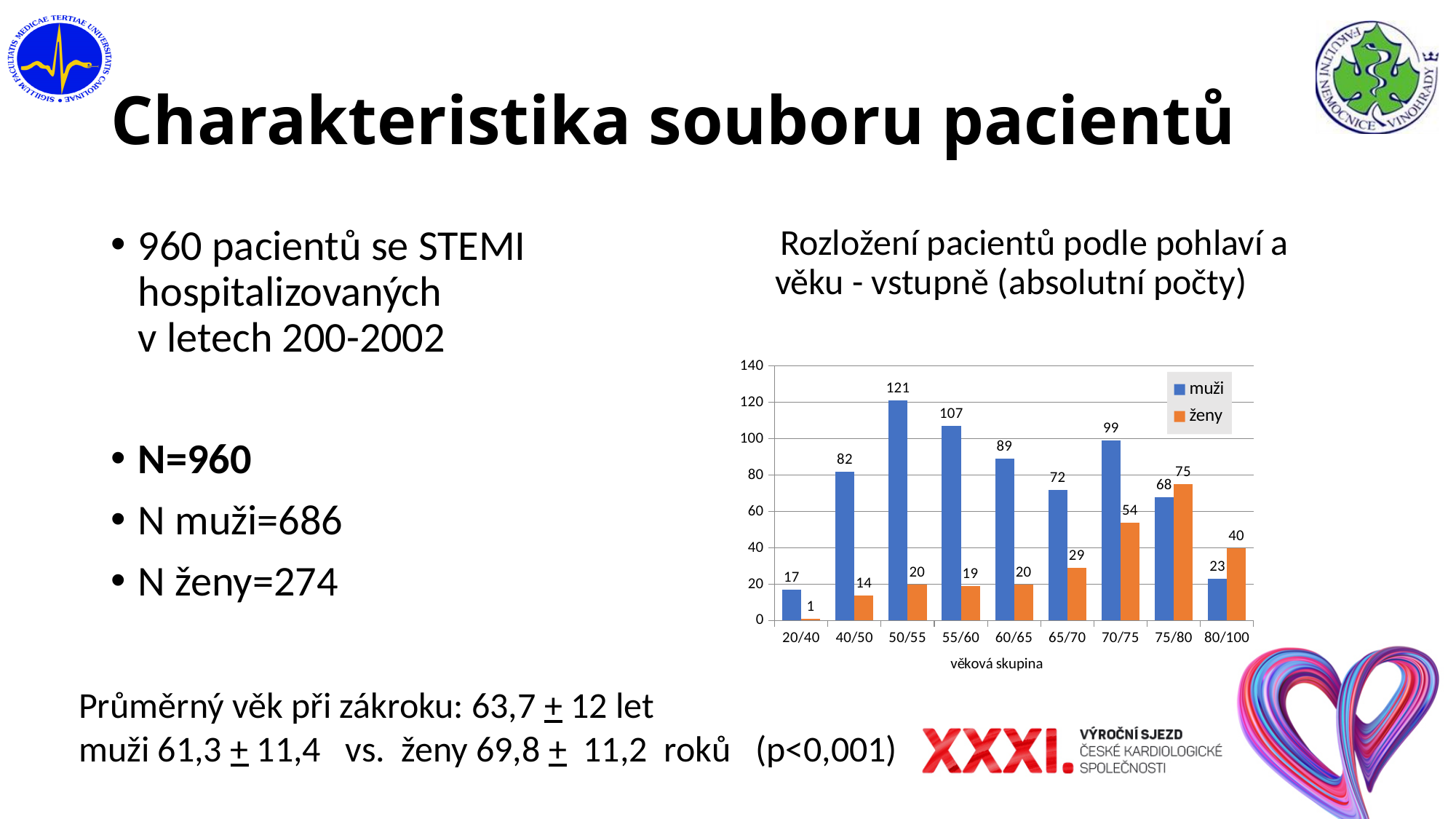
What is the difference between muži and ženy in the 60/65 age group? 69 What is the value for muži in the 50/55 age group? 121 What is the value for ženy in the 70/75 age group? 54 How many age groups are shown on the x axis? 9 Which age group has the lowest value for ženy? 20/40 What kind of chart is shown on the slide? bar chart Do the values for ženy rise or fall from the 65/70 age group to the 80/100 age group? rise How many series does the legend list? 2 In the 75/80 age group, which series has the larger value, muži or ženy? ženy Which age group has the highest value for muži? 50/55 Is the value for muži in the 55/60 age group greater or less than 100? greater What is the label of the x axis of the chart? věková skupina